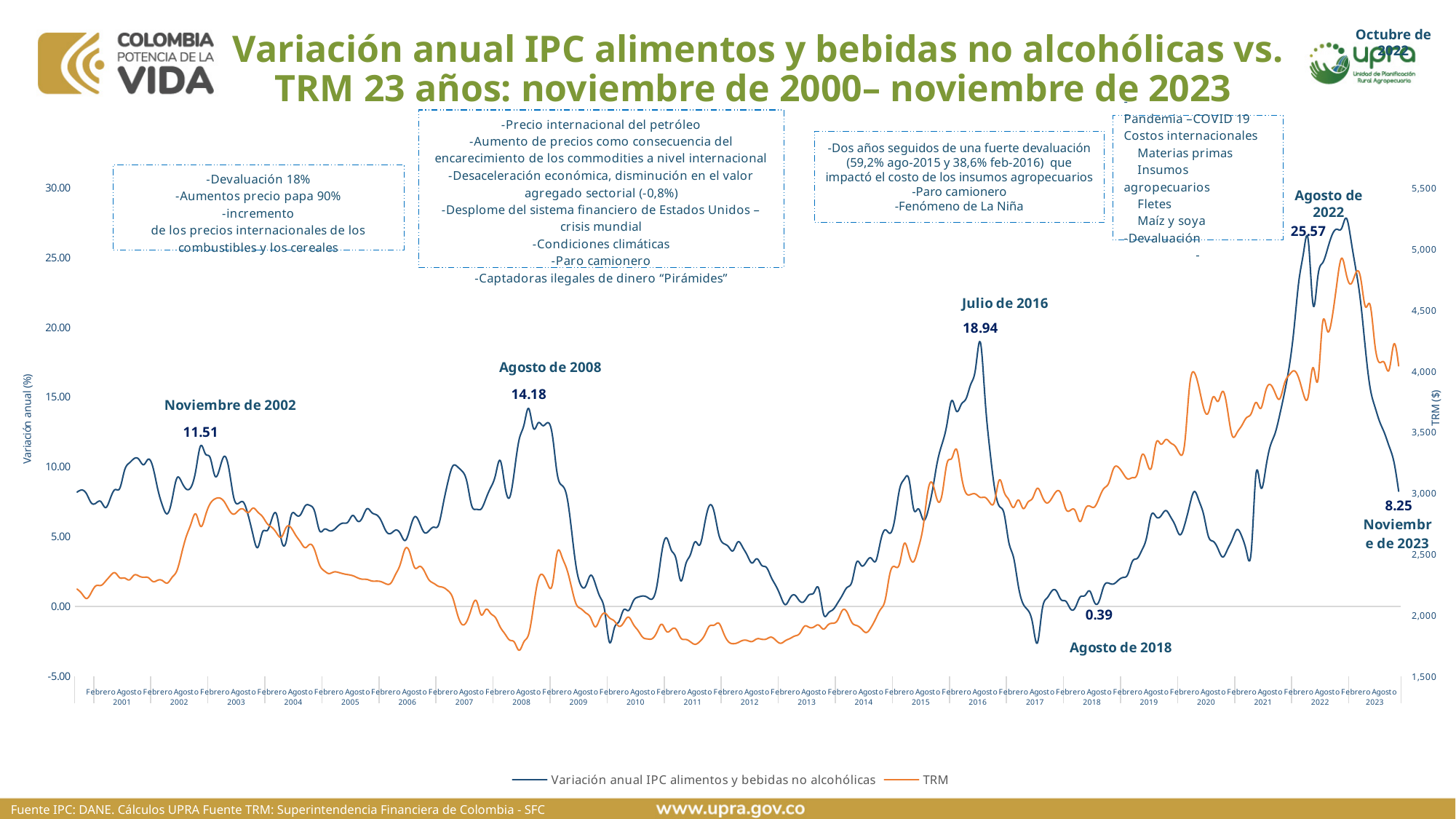
Among the labelled points on the IPC line, which date has the lowest value? Agosto de 2018 How many series does the legend list? 2 What is the labelled value of the annual IPC variation in Agosto de 2018? 0.39 What is the labelled value of the annual IPC variation in Noviembre de 2002? 11.51 What type of chart is shown on the slide? line chart Which is larger, the labelled IPC value for Agosto de 2008 or for Noviembre de 2002? Agosto de 2008 What is the labelled value of the annual IPC variation in Agosto de 2008? 14.18 What is the labelled value of the annual food and non-alcoholic beverages IPC variation in Agosto de 2022? 25.57 What is the difference between the labelled IPC values for Agosto de 2022 and Julio de 2016? 6.63 What is the labelled value of the annual IPC variation in Noviembre de 2023? 8.25 What is the labelled value of the annual IPC variation in Julio de 2016? 18.94 Among the labelled points on the IPC line, which date has the highest value? Agosto de 2022